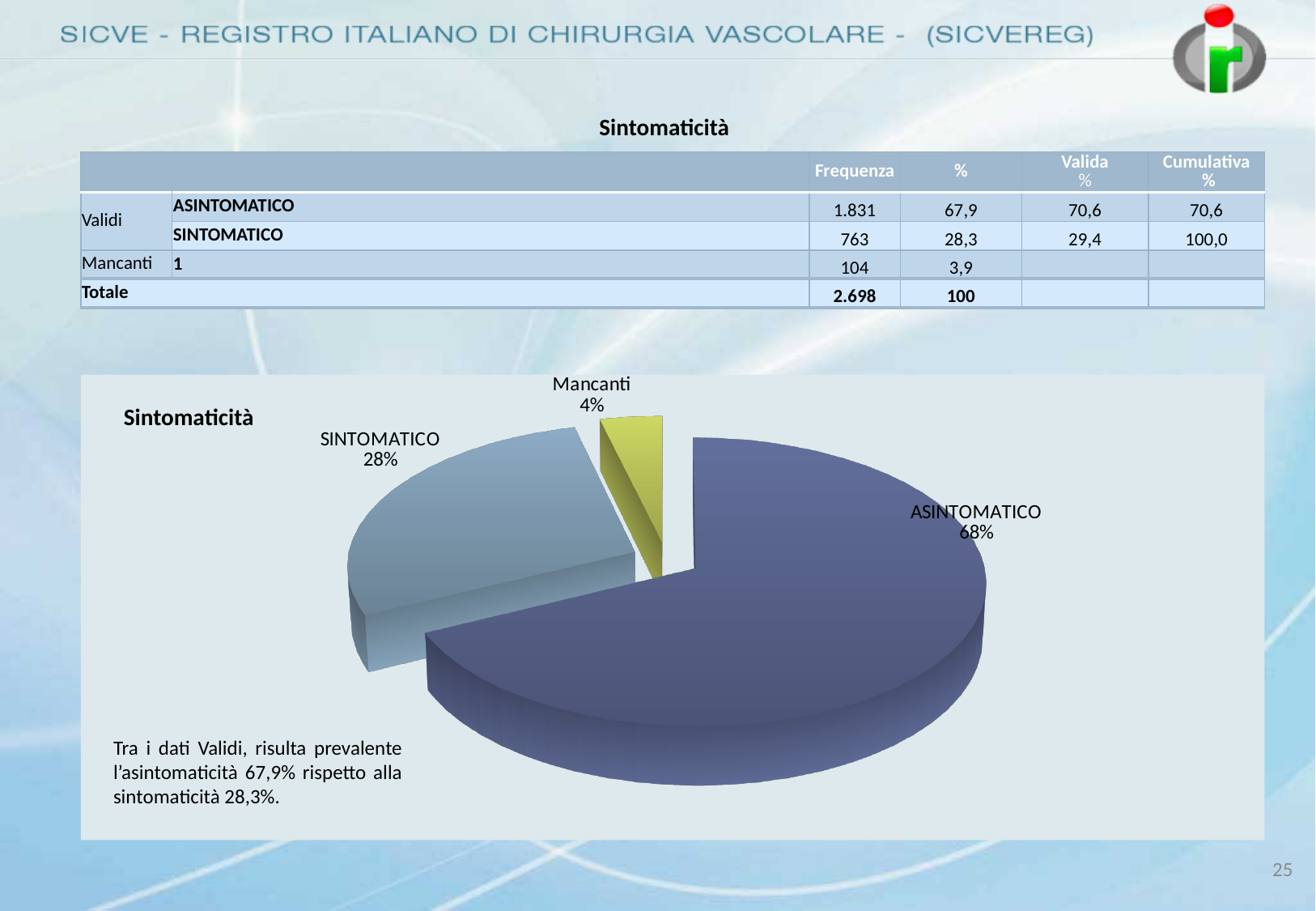
Which slice is larger, SINTOMATICO or Mancanti? SINTOMATICO What share of the pie does SINTOMATICO represent? 28% What is the difference in percentage points between the ASINTOMATICO and SINTOMATICO slices? 40 Which slice of the pie chart is the smallest? Mancanti Which slice of the pie chart is the largest? ASINTOMATICO What is the difference in percentage points between the SINTOMATICO and Mancanti slices? 24 What is the title of the pie chart? Sintomaticità How many slices does the pie chart have? 3 What share of the pie does ASINTOMATICO represent? 68% What kind of chart is shown on the slide? pie chart What share of the pie does Mancanti represent? 4% What colour is the Mancanti slice in the pie chart? yellow